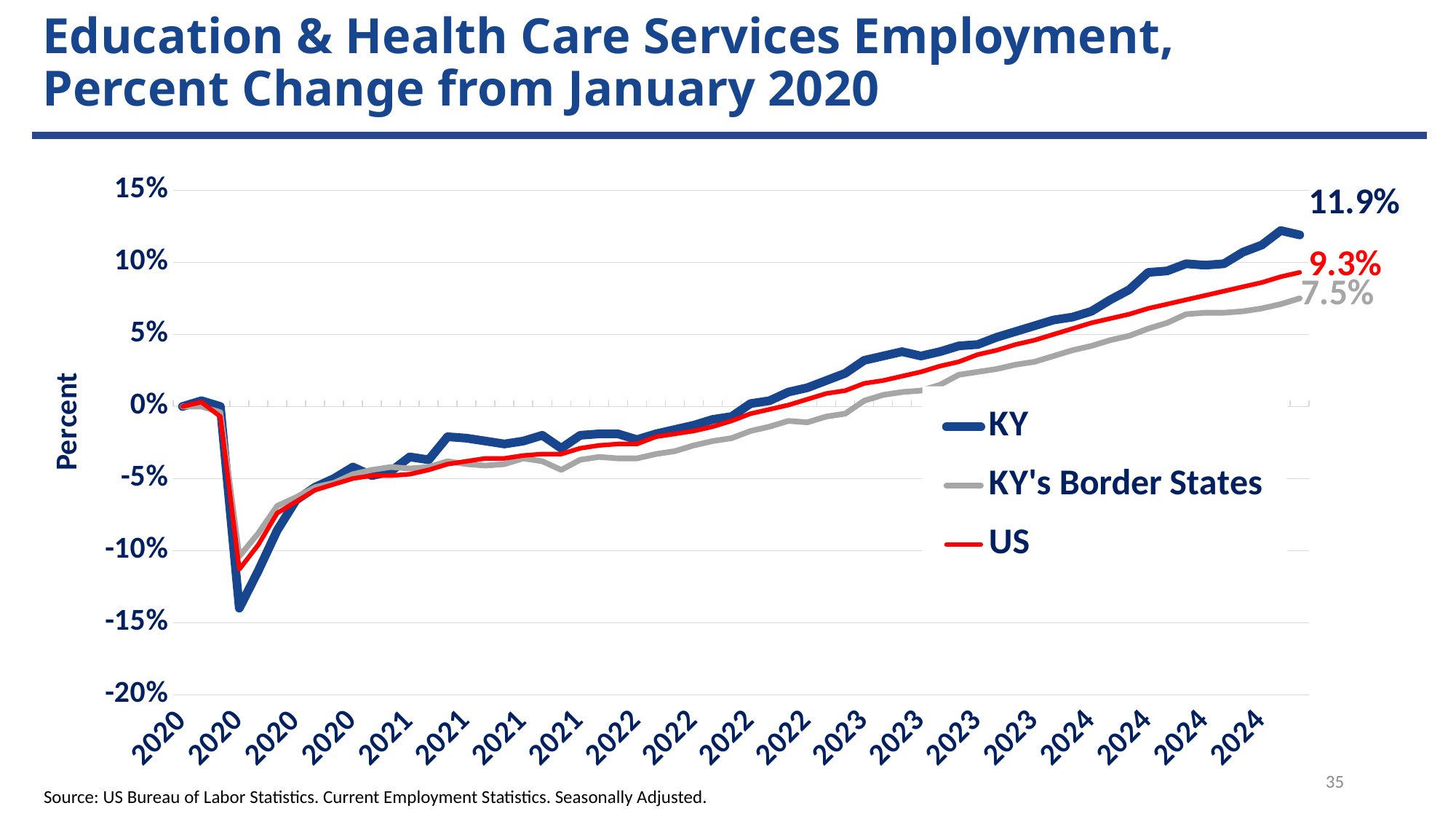
Which series has the lowest value at the end of the chart? KY's Border States What is the difference between the final US value and the final KY's Border States value? 1.8 percentage points What is the final labelled value for the KY's Border States series? 7.5% What colour is the US line in the chart? Red At the end of the chart, which is larger: the KY value or the KY's Border States value? KY What is the final labelled value for the KY series? 11.9% What is the difference between the final KY value and the final US value? 2.6 percentage points How many series does the legend list? 3 What is the final labelled value for the US series? 9.3% What kind of chart is shown on the slide? Line chart Is the lowest value reached by the KY series in 2020 greater or less than -10%? less Which series has the highest value at the end of the chart? KY